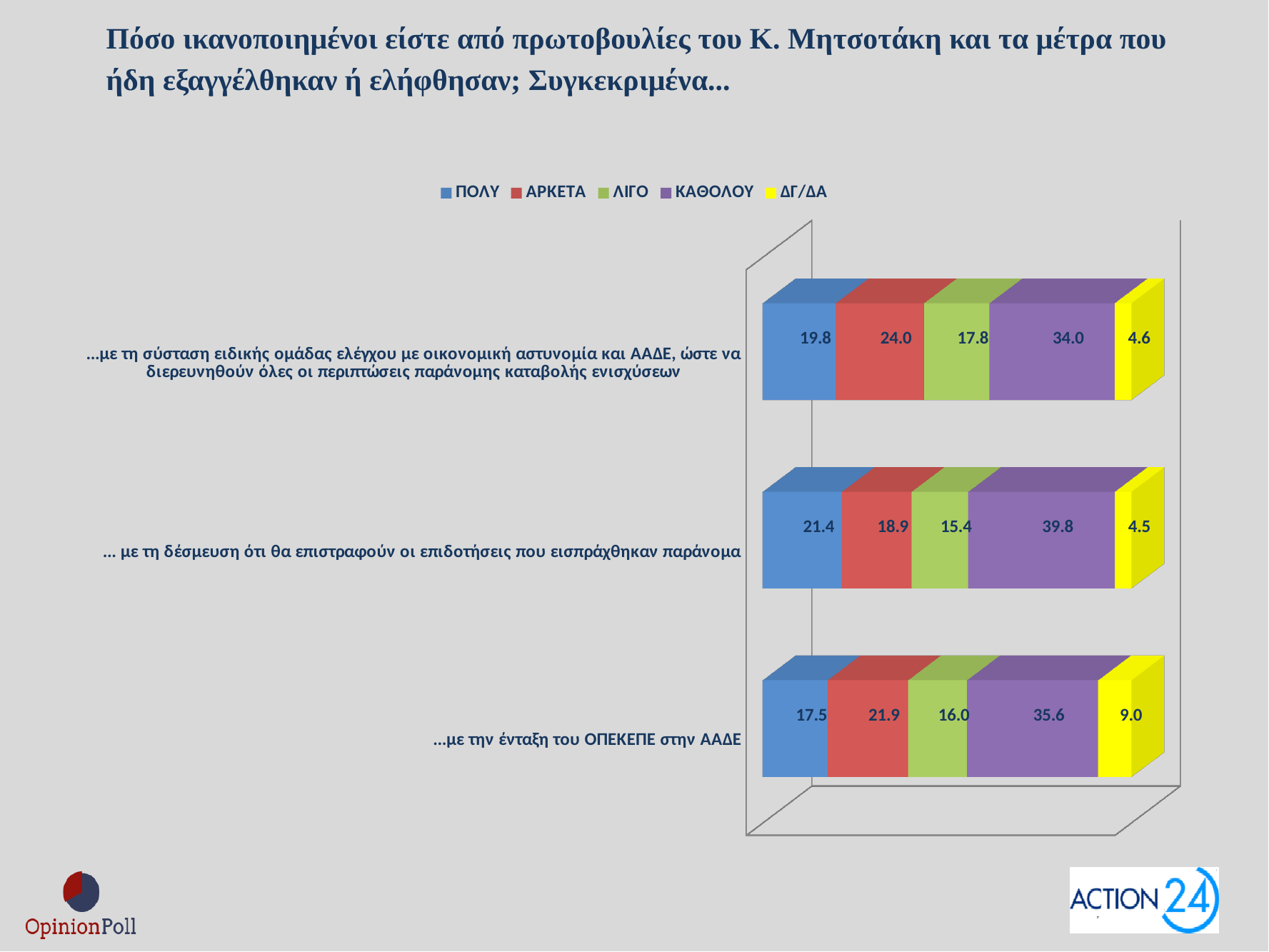
How many categories (bars) does the chart show? 3 Which colour represents the ΔΓ/ΔΑ series in the legend? Yellow What is the ΠΟΛΥ value for the bar about setting up a special audit team with the financial police and ΑΑΔΕ? 19.8 What is the difference between the ΑΡΚΕΤΑ value for the special audit team bar (24.0) and the ΑΡΚΕΤΑ value for the subsidies-return bar (18.9)? 5.1 Which category has the highest ΚΑΘΟΛΟΥ value? ... με τη δέσμευση ότι θα επιστραφούν οι επιδοτήσεις που εισπράχθηκαν παράνομα For the bar about integrating ΟΠΕΚΕΠΕ into ΑΑΔΕ, which is larger: the ΑΡΚΕΤΑ value or the ΛΙΓΟ value? ΑΡΚΕΤΑ What kind of chart is shown on the slide? Stacked bar chart Which category has the lowest ΠΟΛΥ value? ...με την ένταξη του ΟΠΕΚΕΠΕ στην ΑΑΔΕ How many series does the legend list? 5 What is the ΔΓ/ΔΑ value for the bar about integrating ΟΠΕΚΕΠΕ into ΑΑΔΕ ("...με την ένταξη του ΟΠΕΚΕΠΕ στην ΑΑΔΕ")? 9.0 What is the ΚΑΘΟΛΟΥ value for the bar about the commitment that illegally received subsidies will be returned ("... με τη δέσμευση ότι θα επιστραφούν οι επιδοτήσεις που εισπράχθηκαν παράνομα")? 39.8 What is the total of the stacked bar for the subsidies-return category (21.4 + 18.9 + 15.4 + 39.8 + 4.5)? 100.0